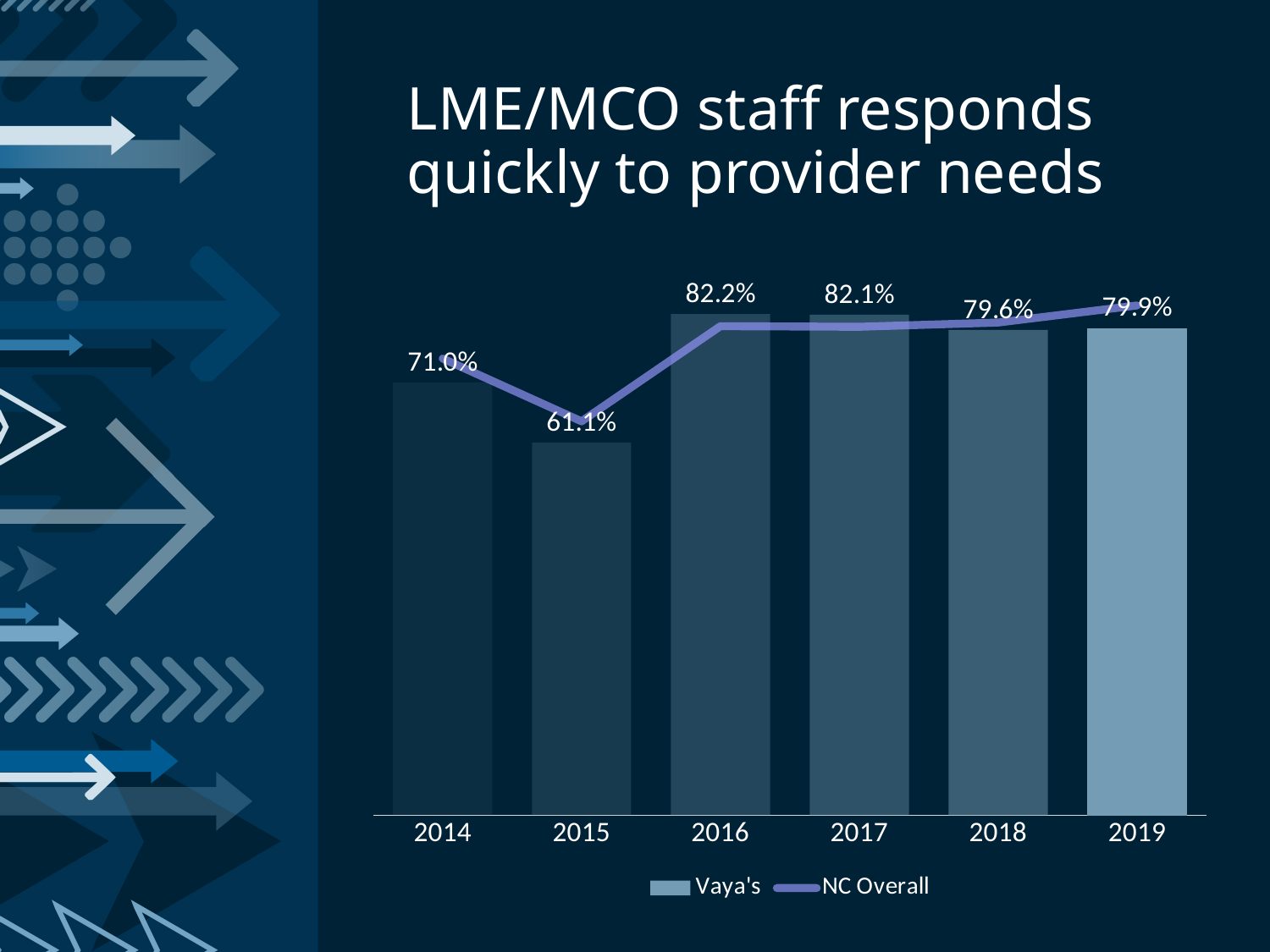
What is the Vaya's value for 2015? 61.1% What is the Vaya's value for 2014? 71.0% How many years are shown on the x axis? 6 Which year has the highest Vaya's value? 2016 What is the Vaya's value for 2016? 82.2% Did the Vaya's value rise or fall from 2014 to 2015? fall Which is larger, the Vaya's value for 2014 or for 2018? 2018 What is the Vaya's value for 2019? 79.9% Which year has the lowest Vaya's value? 2015 Which series is drawn as a line rather than bars? NC Overall What is the difference between the Vaya's values for 2016 and 2015? 21.1% How many series does the legend list? 2